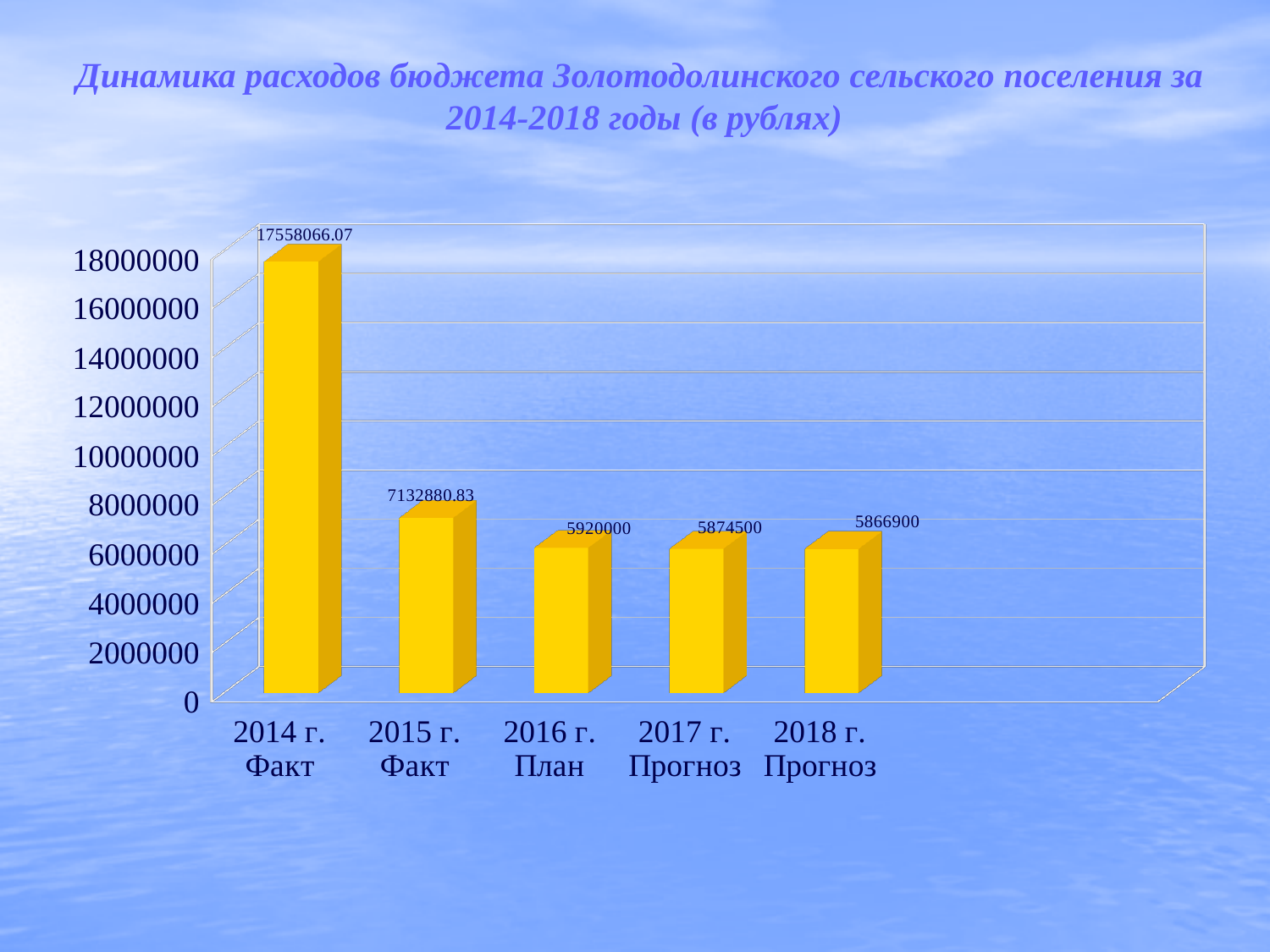
What is the value for 2018 г. Прогноз? 5866900 Is the value for 2015 г. Факт greater or less than 6000000? greater What is the value for 2015 г. Факт? 7132880.83 Which category has the lowest value? 2018 г. Прогноз Which category has the highest value? 2014 г. Факт What is the value for 2017 г. Прогноз? 5874500 What is the difference between the values for 2014 г. Факт and 2015 г. Факт? 10425185.24 What is the value for 2016 г. План? 5920000 What is the difference between the values for 2016 г. План and 2017 г. Прогноз? 45500 Which is larger, the value for 2015 г. Факт or the value for 2016 г. План? 2015 г. Факт What is the value for 2014 г. Факт? 17558066.07 How many categories are shown on the x axis? 5